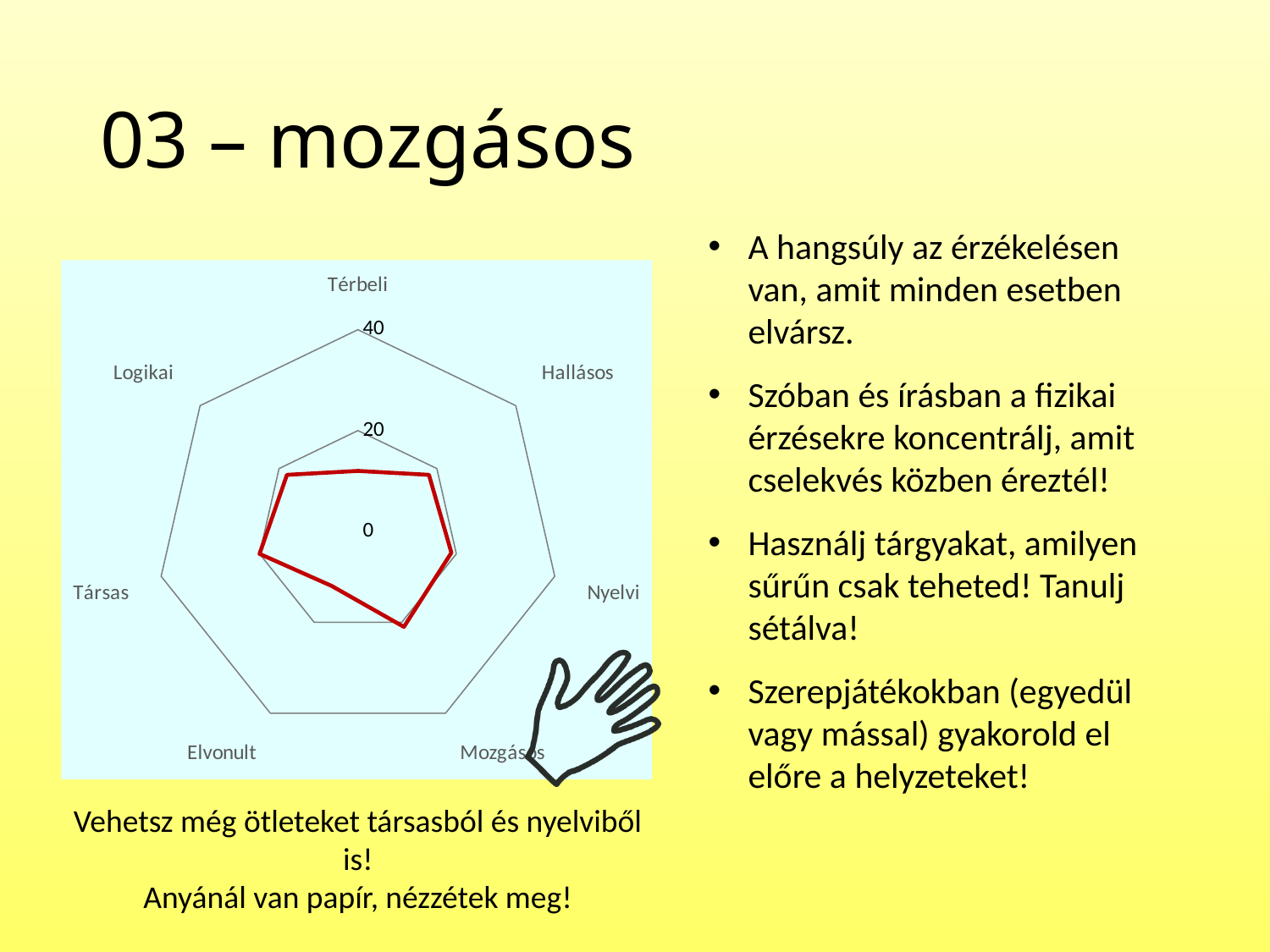
Which category is placed at the top of the radar chart? Térbeli What kind of chart is shown on the slide? radar chart Which is larger, the value for Logikai or the value for Térbeli? Logikai Which is larger, the value for Társas or the value for Térbeli? Társas Is the value for Elvonult greater or less than 20? less Is the value for Logikai greater or less than 40? less Which is larger, the value for Mozgásos or the value for Térbeli? Mozgásos What is the highest value shown on the chart's axis scale? 40 Is the value for Mozgásos greater or less than 40? less How many categories (axes) does the radar chart have? 7